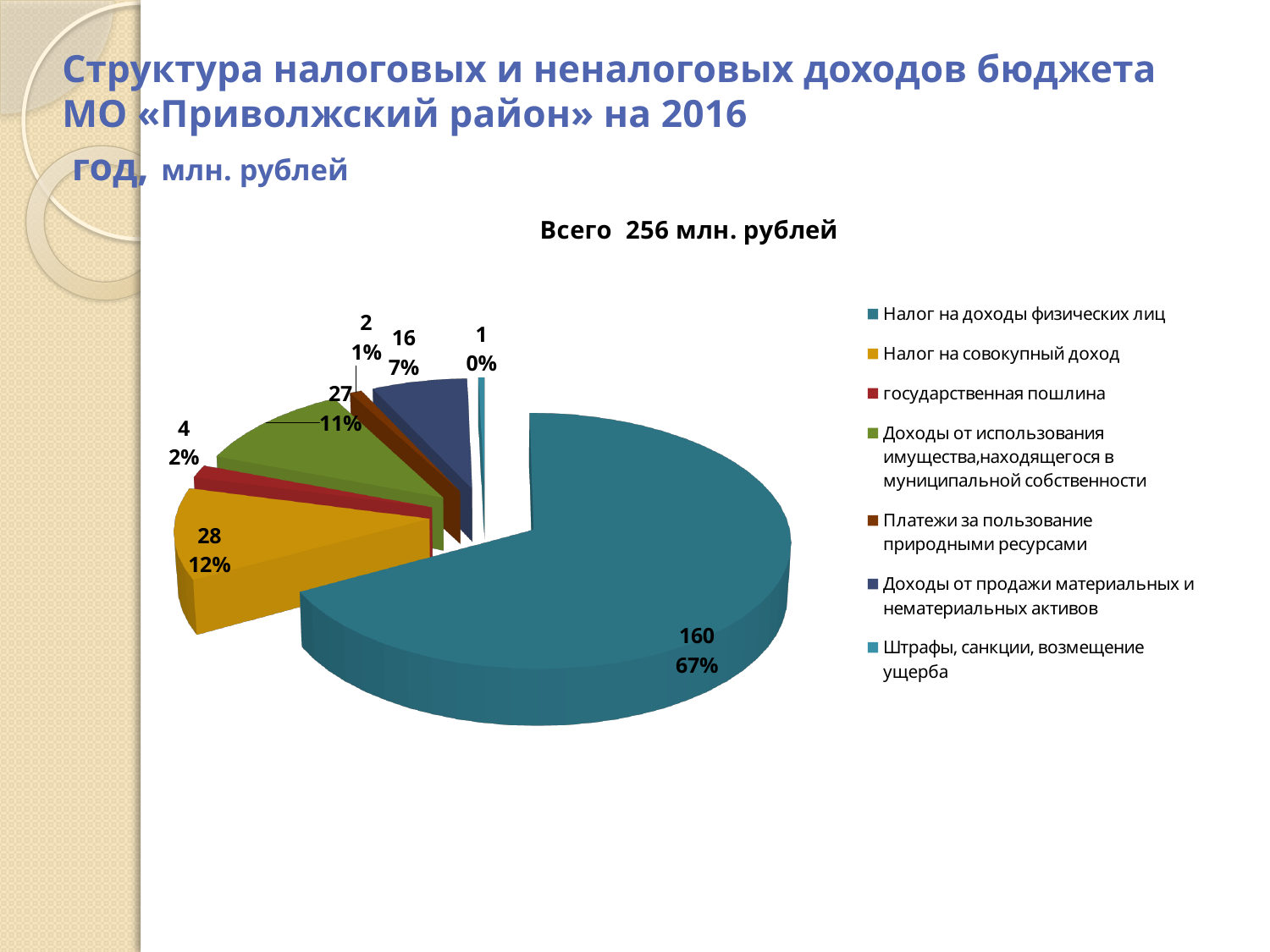
What is the value for государственная пошлина? 4 Which category has the smallest slice of the pie? Штрафы, санкции, возмещение ущерба What total amount is stated in the chart title? 256 млн. рублей What is the value for Налог на доходы физических лиц? 160 Which category has the largest slice of the pie? Налог на доходы физических лиц What is the value for Доходы от использования имущества, находящегося в муниципальной собственности? 27 What kind of chart is shown on the slide? pie chart What is the difference between the values for Налог на доходы физических лиц and Налог на совокупный доход? 132 What share of the pie does Доходы от продажи материальных и нематериальных активов represent? 7% Which is larger: the value for Налог на совокупный доход or the value for Доходы от продажи материальных и нематериальных активов? Налог на совокупный доход What share of the pie does Налог на совокупный доход represent? 12% How many categories does the legend list? 7